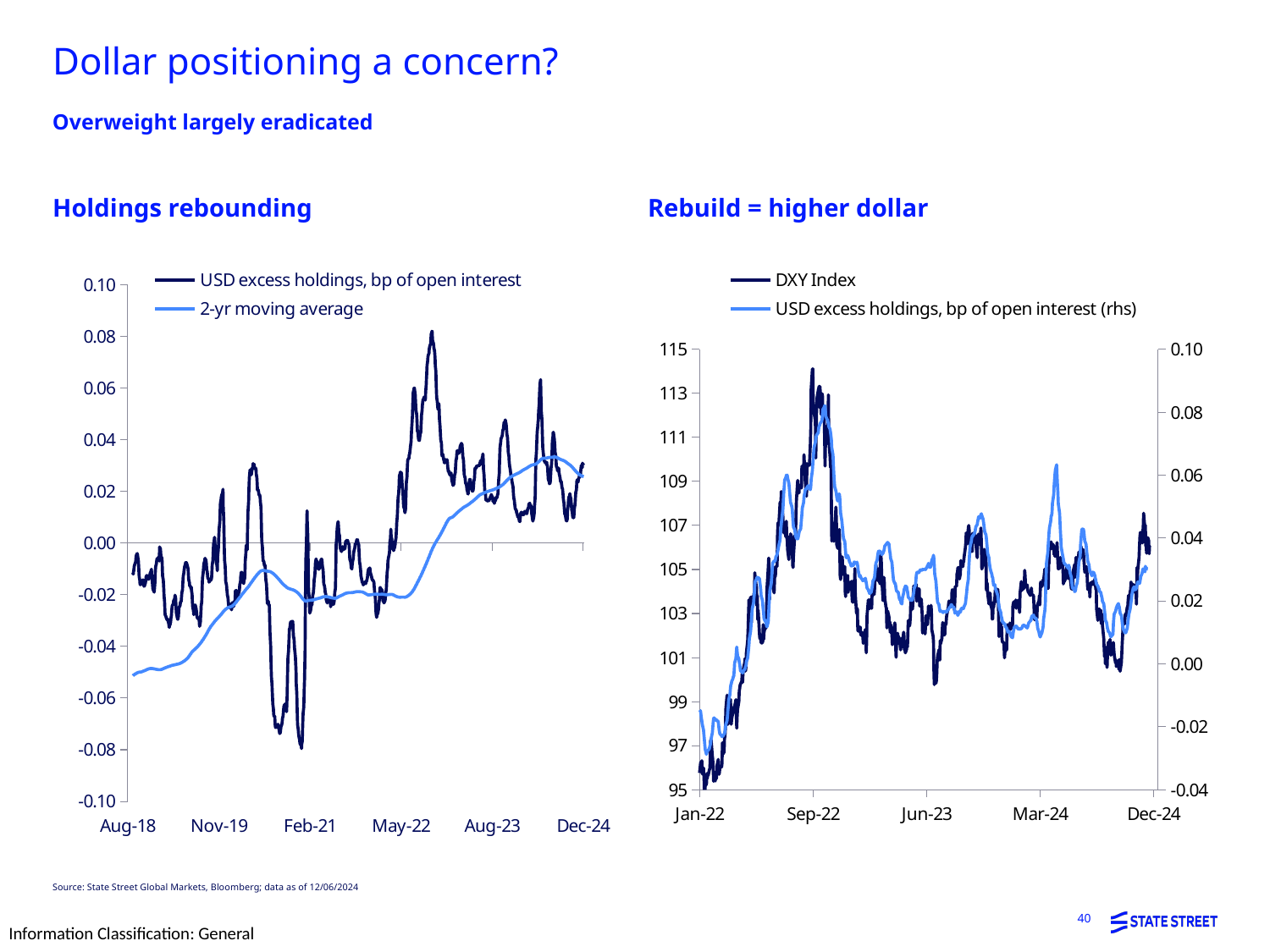
In the 'Rebuild = higher dollar' chart, does the DXY Index rise or fall between Jan-22 and Sep-22? rise In the 'Holdings rebounding' chart, is the 2-yr moving average at Dec-24 greater or less than 0.00? greater In the 'Holdings rebounding' chart, does the 2-yr moving average rise or fall overall from Aug-18 to Dec-24? rise How many series does the legend of the 'Rebuild = higher dollar' chart list? 2 What kind of chart is the 'Rebuild = higher dollar' chart? line chart What kind of chart is the 'Holdings rebounding' chart? line chart In the 'Rebuild = higher dollar' chart, is the DXY Index peak around Sep-22 greater or less than 110? greater In the 'Holdings rebounding' chart, which series is drawn in light blue? 2-yr moving average In the 'Rebuild = higher dollar' chart, is the DXY Index at Jan-22 greater or less than 100? less How many series does the legend of the 'Holdings rebounding' chart list? 2 In the 'Rebuild = higher dollar' chart, which series is plotted on the right-hand axis? USD excess holdings, bp of open interest (rhs)